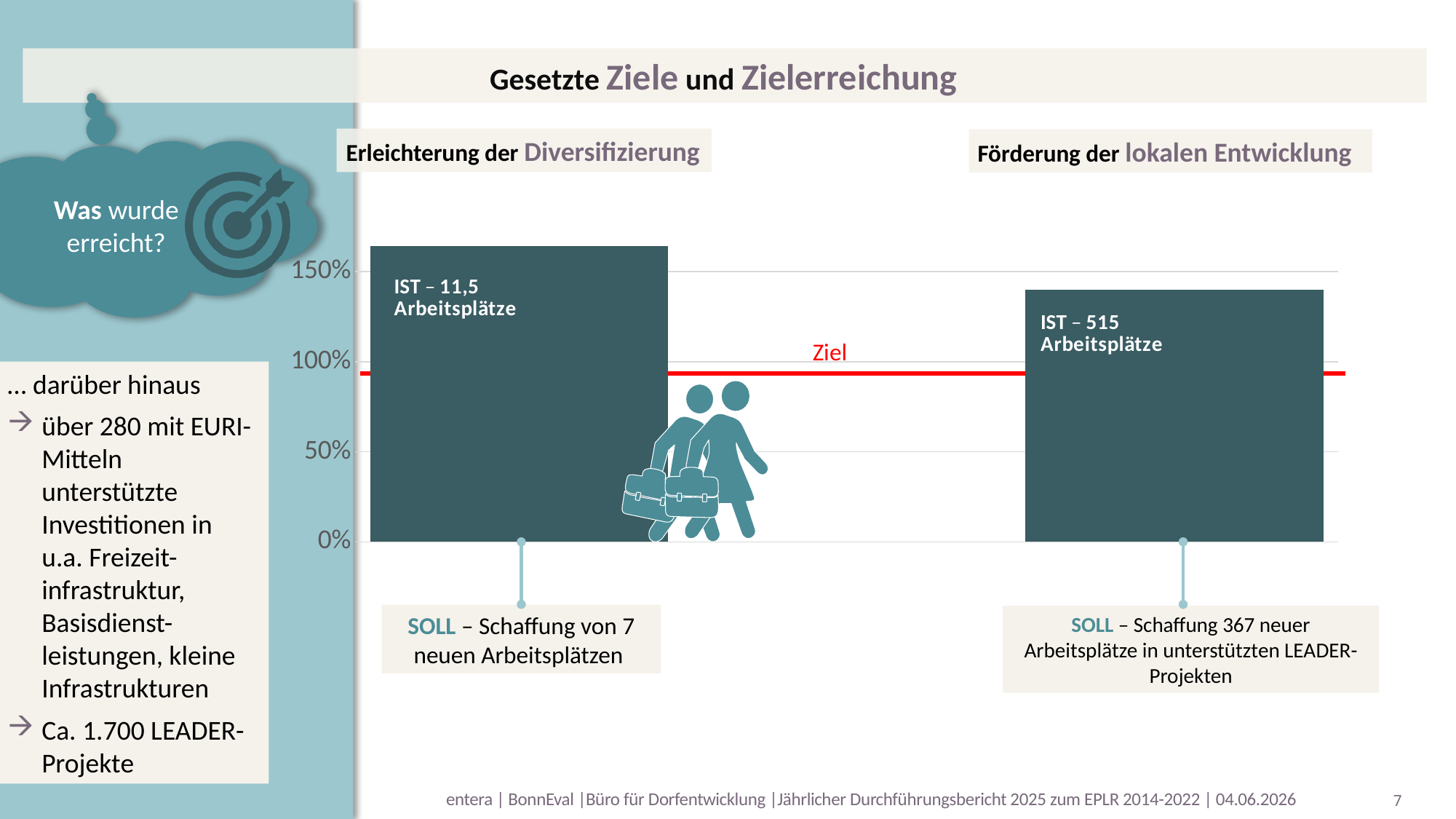
What is the SOLL target stated below the bar for 'Förderung der lokalen Entwicklung'? Schaffung 367 neuer Arbeitsplätze in unterstützten LEADER-Projekten Which bar is taller, 'Erleichterung der Diversifizierung' or 'Förderung der lokalen Entwicklung'? Erleichterung der Diversifizierung What label is written on the red horizontal line in the chart? Ziel Is the bar for 'Erleichterung der Diversifizierung' greater or less than 150%? greater What is the SOLL target stated below the bar for 'Erleichterung der Diversifizierung'? Schaffung von 7 neuen Arbeitsplätzen What IST value is printed on the bar for 'Förderung der lokalen Entwicklung'? 515 Arbeitsplätze What is the highest tick value shown on the vertical axis? 150% What IST value is printed on the bar for 'Erleichterung der Diversifizierung'? 11,5 Arbeitsplätze Is the bar for 'Förderung der lokalen Entwicklung' greater or less than 150%? less How many bars does the chart show? 2 What kind of chart is shown on the slide? bar chart Is the bar for 'Förderung der lokalen Entwicklung' greater or less than 100%? greater